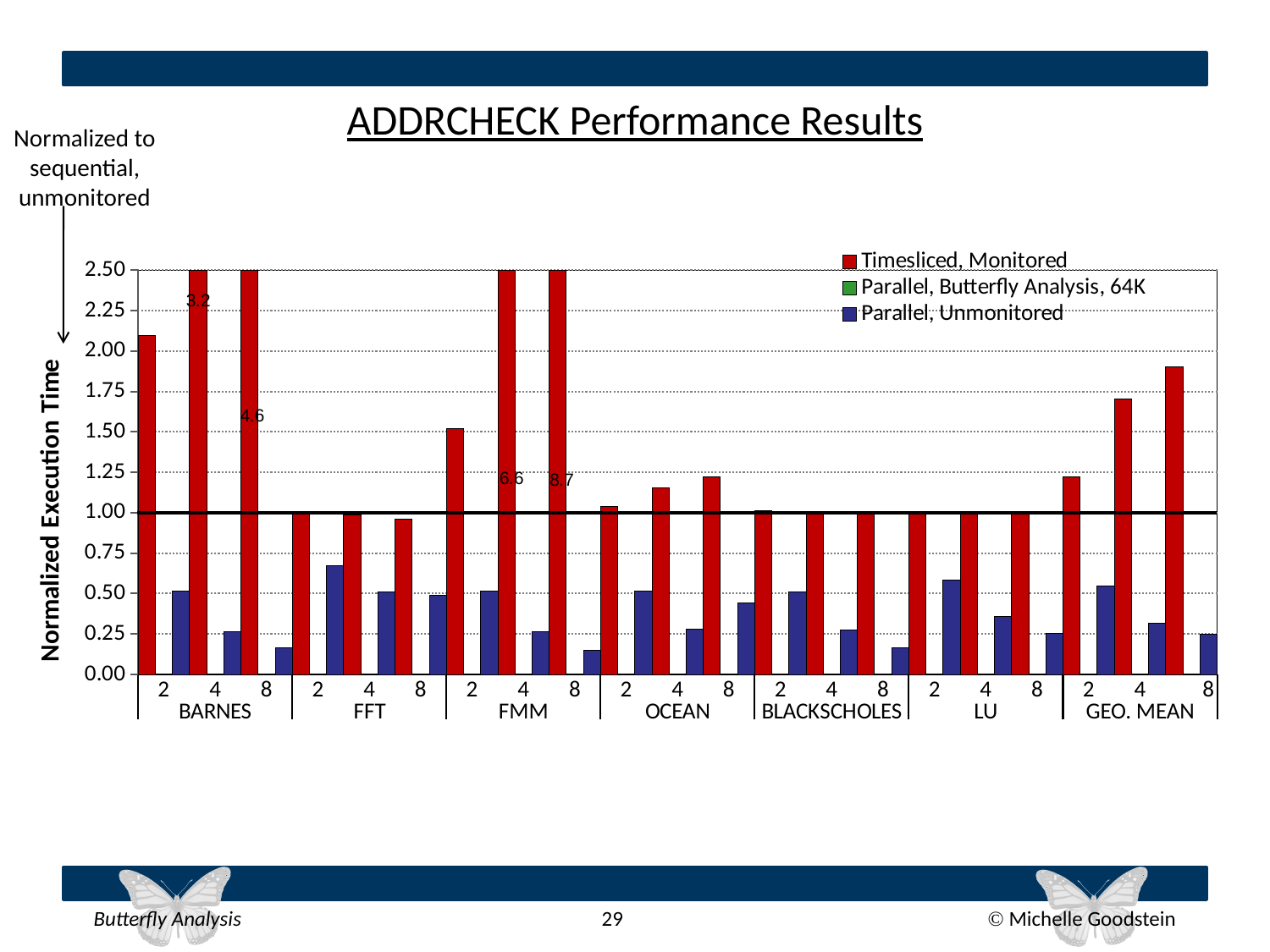
How many series does the legend list? 3 What kind of chart is shown on the slide? bar chart What is the Timesliced, Monitored value for FMM at 4 threads? 6.6 What is the Timesliced, Monitored value for FMM at 8 threads? 8.7 What is the difference between the Timesliced, Monitored values for FMM at 8 threads and FMM at 4 threads? 2.1 Which benchmark and thread count has the highest Timesliced, Monitored value? FMM at 8 threads How many benchmark groups are shown along the x axis? 7 Is the Parallel, Unmonitored value for FFT at 2 threads greater or less than 0.50? greater What is the Timesliced, Monitored value for BARNES at 8 threads? 4.6 Which has the larger Timesliced, Monitored value: FMM at 8 threads or BARNES at 8 threads? FMM at 8 threads What is the Timesliced, Monitored value for BARNES at 4 threads? 3.2 Is the Timesliced, Monitored value for GEO. MEAN at 8 threads greater or less than 1.75? greater